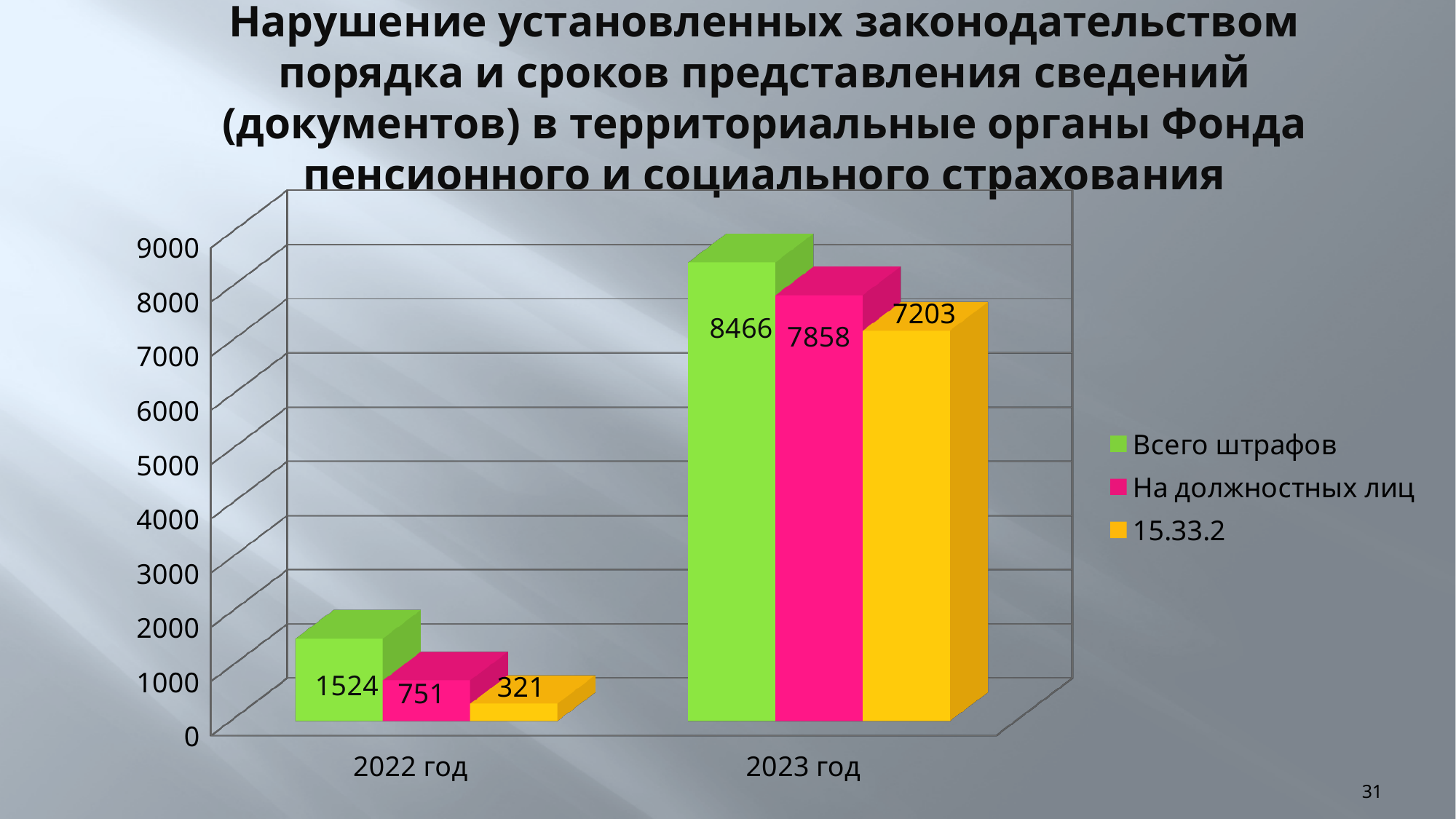
What is the difference between "На должностных лиц" and "15.33.2" in 2023 год? 655 Which series has the lowest value in 2022 год? 15.33.2 Which is larger: "На должностных лиц" in 2022 год or "15.33.2" in 2022 год? На должностных лиц Does the value of "Всего штрафов" rise or fall from 2022 год to 2023 год? Rise What is the value of "Всего штрафов" for 2022 год? 1524 Which year has the higher value for "15.33.2"? 2023 год What is the value of "15.33.2" for 2023 год? 7203 What is the difference between "Всего штрафов" in 2023 год and in 2022 год? 6942 What is the value of "Всего штрафов" for 2023 год? 8466 What is the value of "На должностных лиц" for 2022 год? 751 How many series does the legend list? 3 What kind of chart is shown on the slide? Bar chart